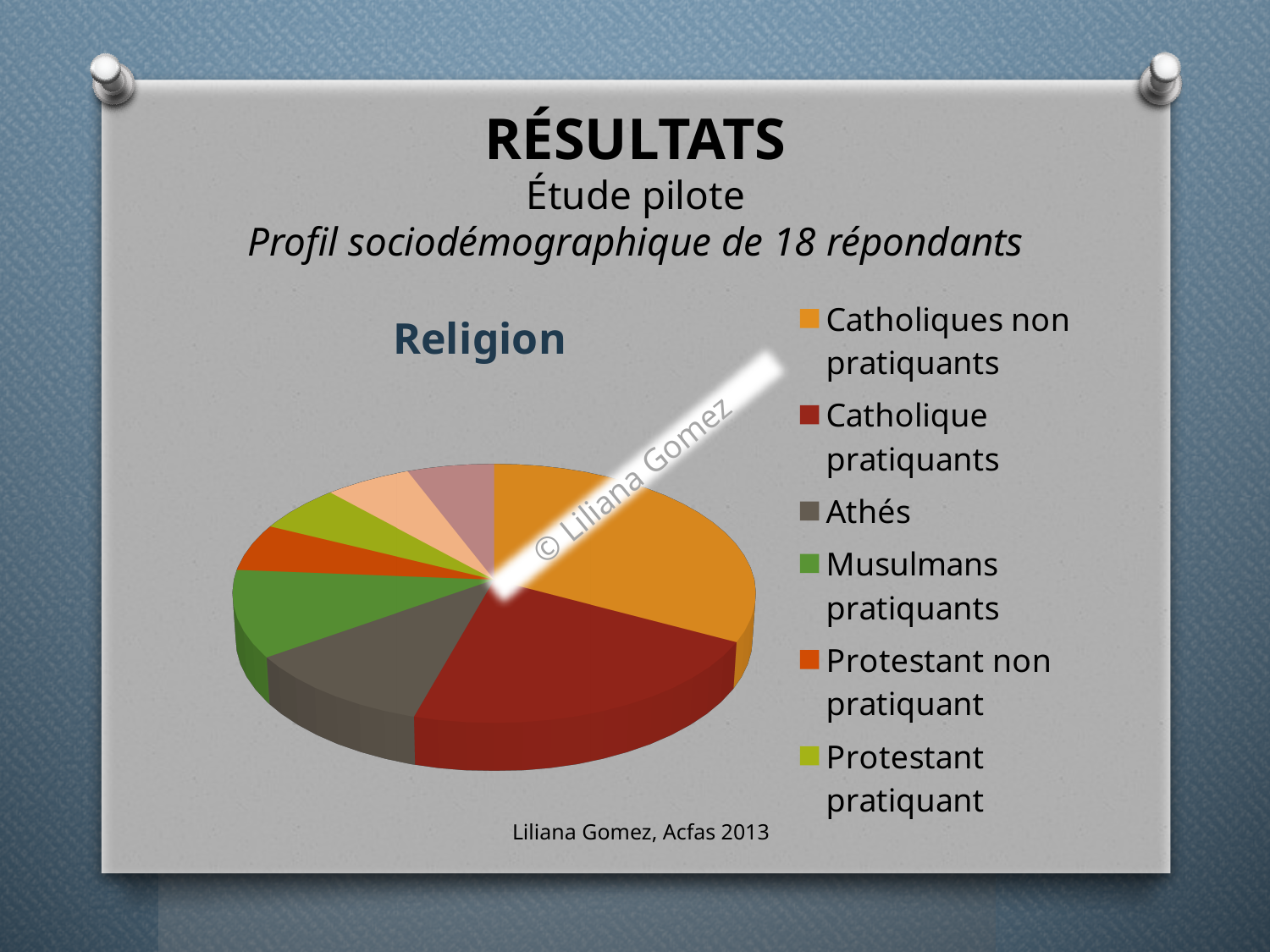
Which slice is larger, Catholiques non pratiquants or Protestant non pratiquant? Catholiques non pratiquants Which slice is larger, Catholiques non pratiquants or Athés? Catholiques non pratiquants Which slice is larger, Athés or Protestant pratiquant? Athés What colour represents Athés in the pie chart? gray What is the title of the chart? Religion How many slices does the pie chart have? 8 Which category has the largest slice of the pie? Catholiques non pratiquants What kind of chart is shown on the slide? pie chart How many entries does the chart legend list? 6